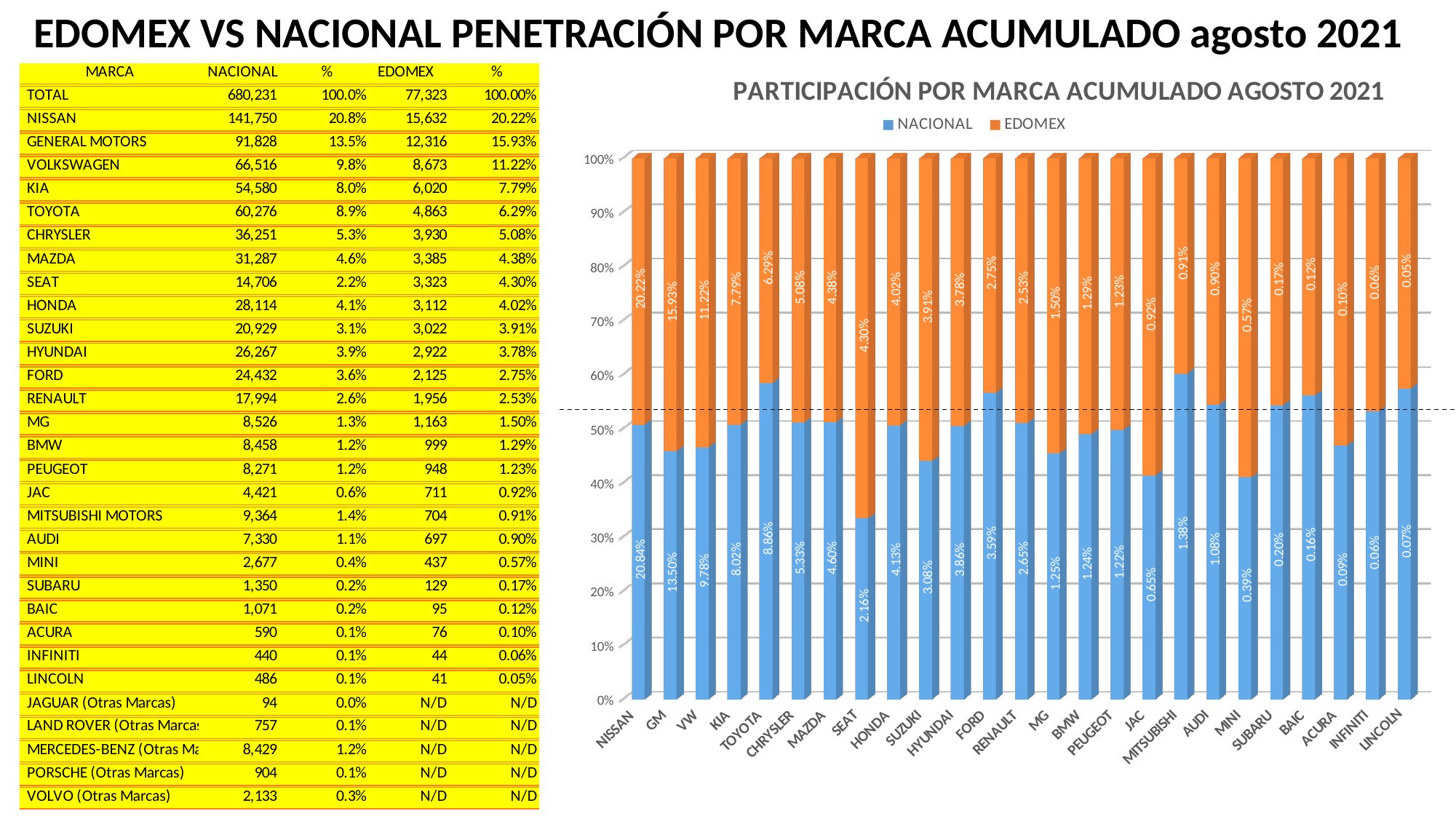
What is the NACIONAL value shown for MITSUBISHI in the chart? 1.38% Which brand has the highest NACIONAL value in the chart? NISSAN How many series does the chart legend list? 2 What is the EDOMEX value shown for GM in the chart? 15.93% What is the EDOMEX value shown for SEAT in the chart? 4.30% How many brands are shown on the x axis of the chart? 25 What kind of chart is shown on the slide? Stacked bar chart What is the difference between the EDOMEX and NACIONAL values for SEAT? 2.14% Which is larger for TOYOTA, the NACIONAL value or the EDOMEX value? NACIONAL What is the NACIONAL value shown for NISSAN in the chart? 20.84% What is the title of the chart? PARTICIPACIÓN POR MARCA ACUMULADO AGOSTO 2021 Which brand has the lowest EDOMEX value in the chart? LINCOLN